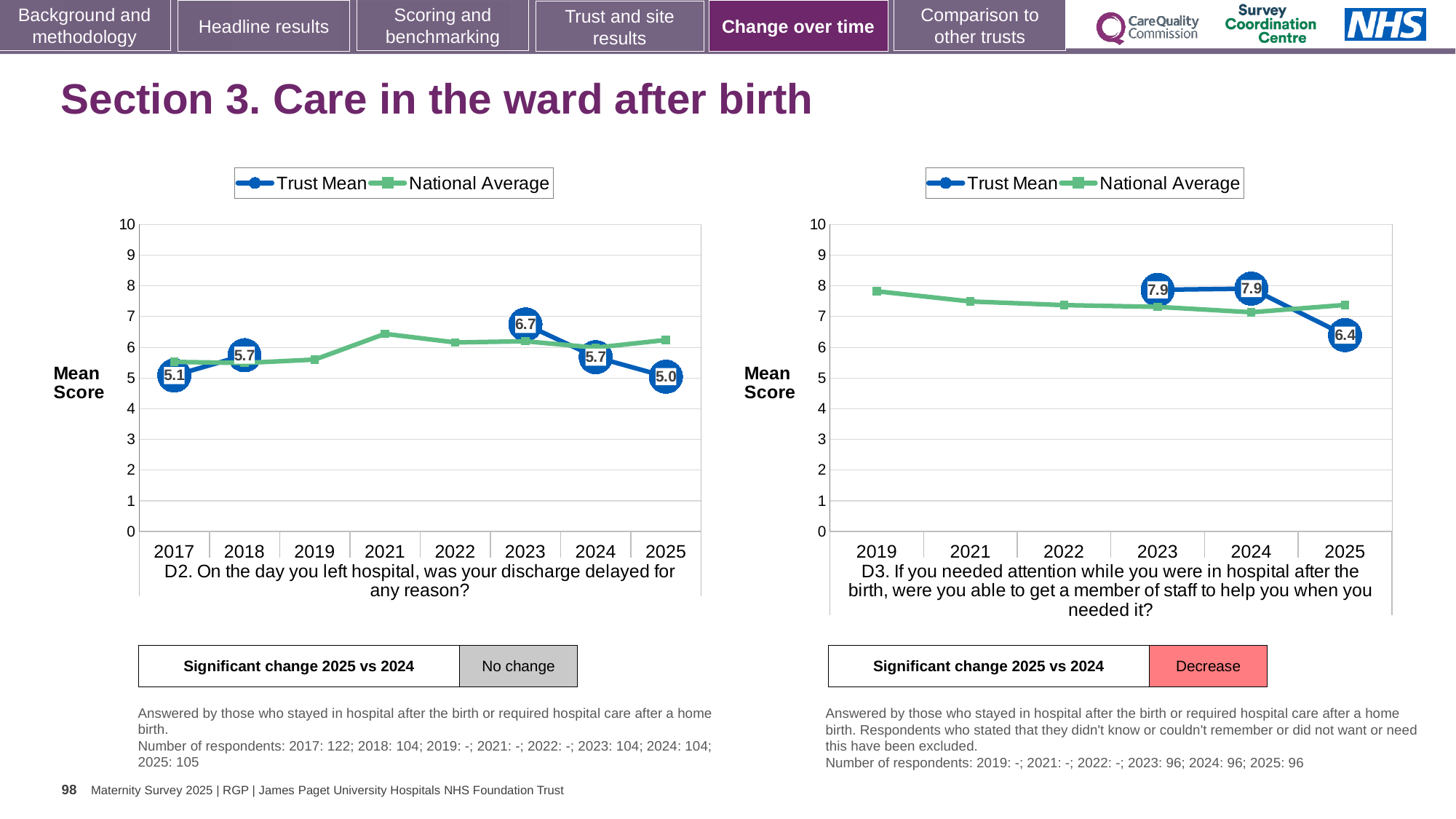
In the D3 chart (right), what is the difference between the Trust Mean in 2024 and in 2025? 1.5 In the D3 chart (right), is the Trust Mean larger in 2023 or in 2025? 2023 In the D2 chart (left), which year has the highest labelled Trust Mean? 2023 In the D2 chart (left), what is the Trust Mean for 2025? 5.0 In the D2 chart (left), how many years are shown on the x axis? 8 In the D2 chart (left), what is the difference between the Trust Mean in 2023 and in 2024? 1.0 In the D3 chart (right), is the National Average for 2019 greater or less than 7? greater In the D2 chart (left), what is the Trust Mean for 2023? 6.7 In the D3 chart (right), what is the Trust Mean for 2025? 6.4 What kind of chart is the D2 chart (left)? Line chart How many series does the legend of the D3 chart (right) list? 2 In the D2 chart (left), which year has the lowest labelled Trust Mean? 2025